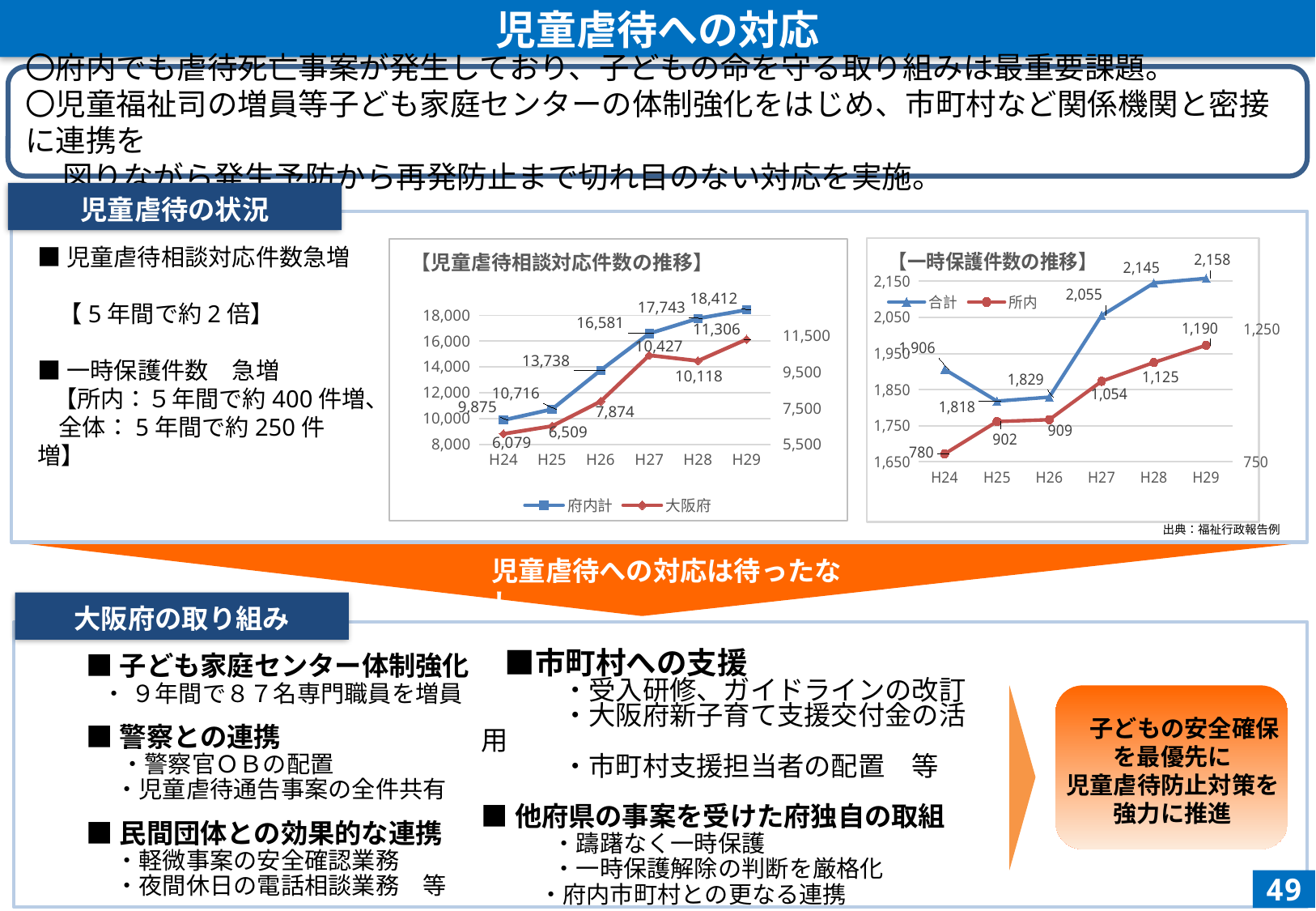
In the 【児童虐待相談対応件数の推移】 chart, what is the value of 大阪府 for H27? 10,427 What type of chart is the 【一時保護件数の推移】 chart? line chart In the 【児童虐待相談対応件数の推移】 chart, which year has the lowest value for 府内計? H24 In the 【児童虐待相談対応件数の推移】 chart, what is the value of 府内計 for H29? 18,412 In the 【一時保護件数の推移】 chart, how many years are shown on the x axis? 6 In the 【一時保護件数の推移】 chart, which year has the highest value for 合計? H29 In the 【一時保護件数の推移】 chart, what is the value of 合計 for H28? 2,145 In the 【一時保護件数の推移】 chart, what is the difference between the 所内 values for H29 and H24? 410 In the 【児童虐待相談対応件数の推移】 chart, what is the difference between the 府内計 values for H29 and H24? 8,537 In the 【一時保護件数の推移】 chart, what is the value of 所内 for H26? 909 In the 【児童虐待相談対応件数の推移】 chart, does the 大阪府 value rise or fall from H27 to H28? fall In the 【児童虐待相談対応件数の推移】 chart, how many series does the legend list? 2